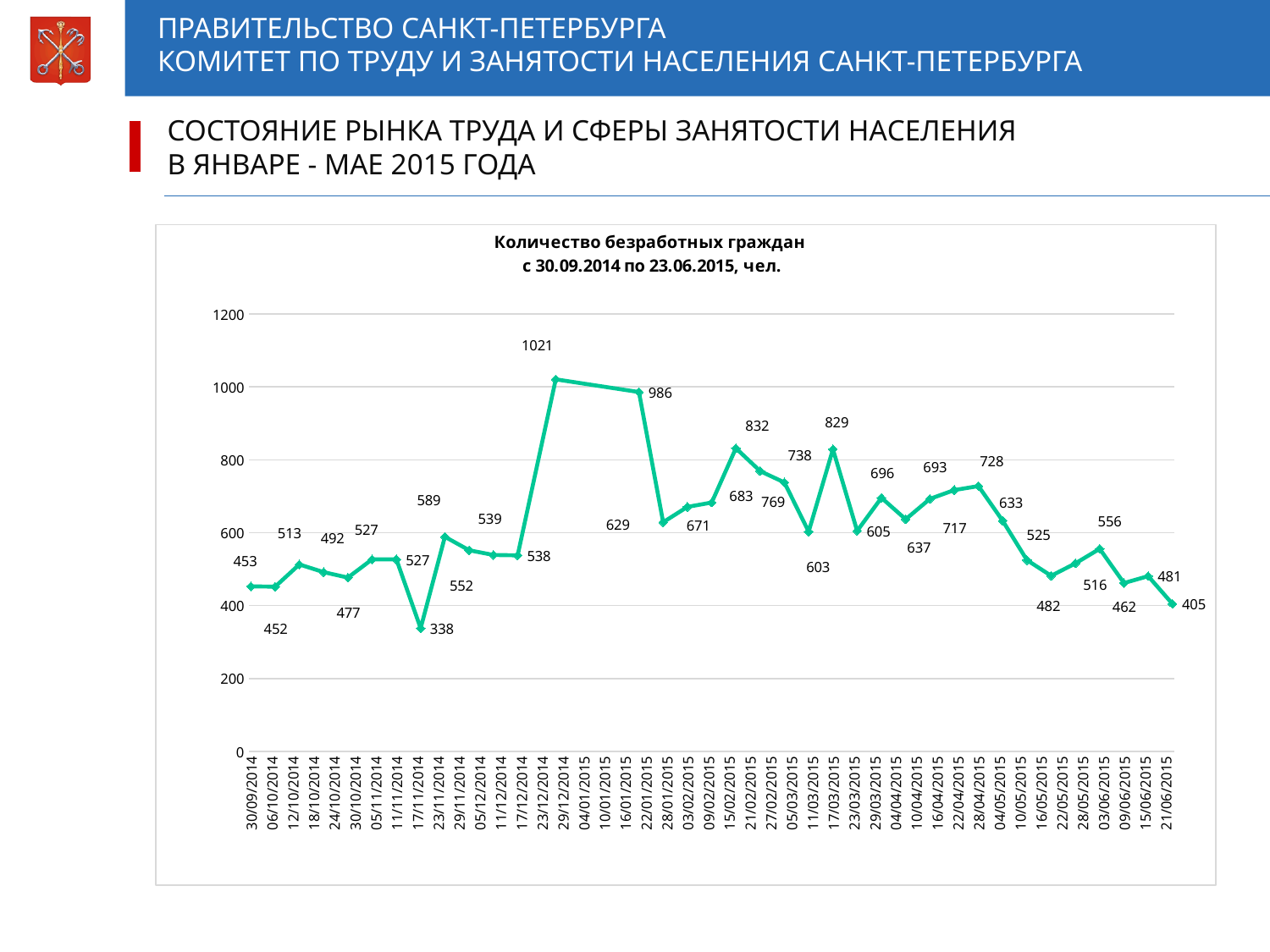
What is the lowest value labelled on the line? 338 What is the difference between the highest labelled value (1021) and the lowest labelled value (338)? 683 What is the title of the chart? Количество безработных граждан с 30.09.2014 по 23.06.2015, чел. What is the difference between the first value (453) and the last value (405) of the series? 48 Which is larger, the labelled value 986 or the labelled value 832? 986 Is the peak value of the series greater or less than 1000? greater What is the highest value labelled on the line? 1021 What kind of chart is shown on the slide? line chart What is the value at the first point of the series, 30/09/2014? 453 What is the value at the last point of the series, 21/06/2015? 405 From the peak of 1021 to the end of the series, do the values generally rise or fall? fall How many lines (series) are plotted on the chart? 1